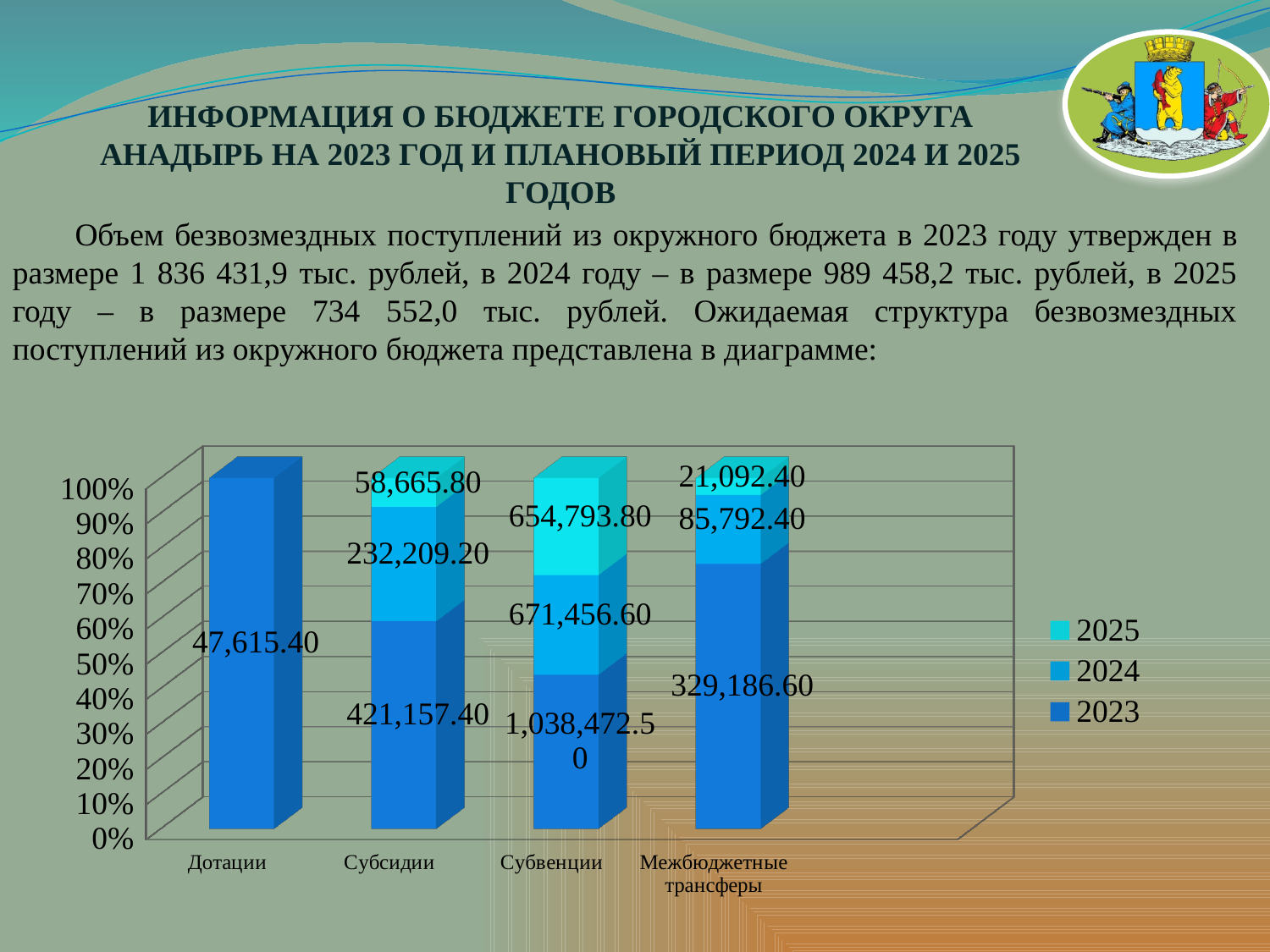
What is the 2024 value for Межбюджетные трансферы? 85,792.40 Which category has the highest 2025 value? Субвенции What is the value shown for Дотации? 47,615.40 What is the total of the three values in the Субсидии bar? 712,032.40 What is the 2025 value for Субвенции? 654,793.80 Which category has the highest 2023 value? Субвенции What is the difference between the 2024 and 2025 values for Межбюджетные трансферы? 64,700.00 Which is larger: the 2024 value for Субсидии or the 2024 value for Межбюджетные трансферы? Субсидии How many categories are shown on the x axis? 4 What is the 2023 value for Субсидии? 421,157.40 What is the difference between the 2023 and 2024 values for Субсидии? 188,948.20 How many series does the legend list? 3